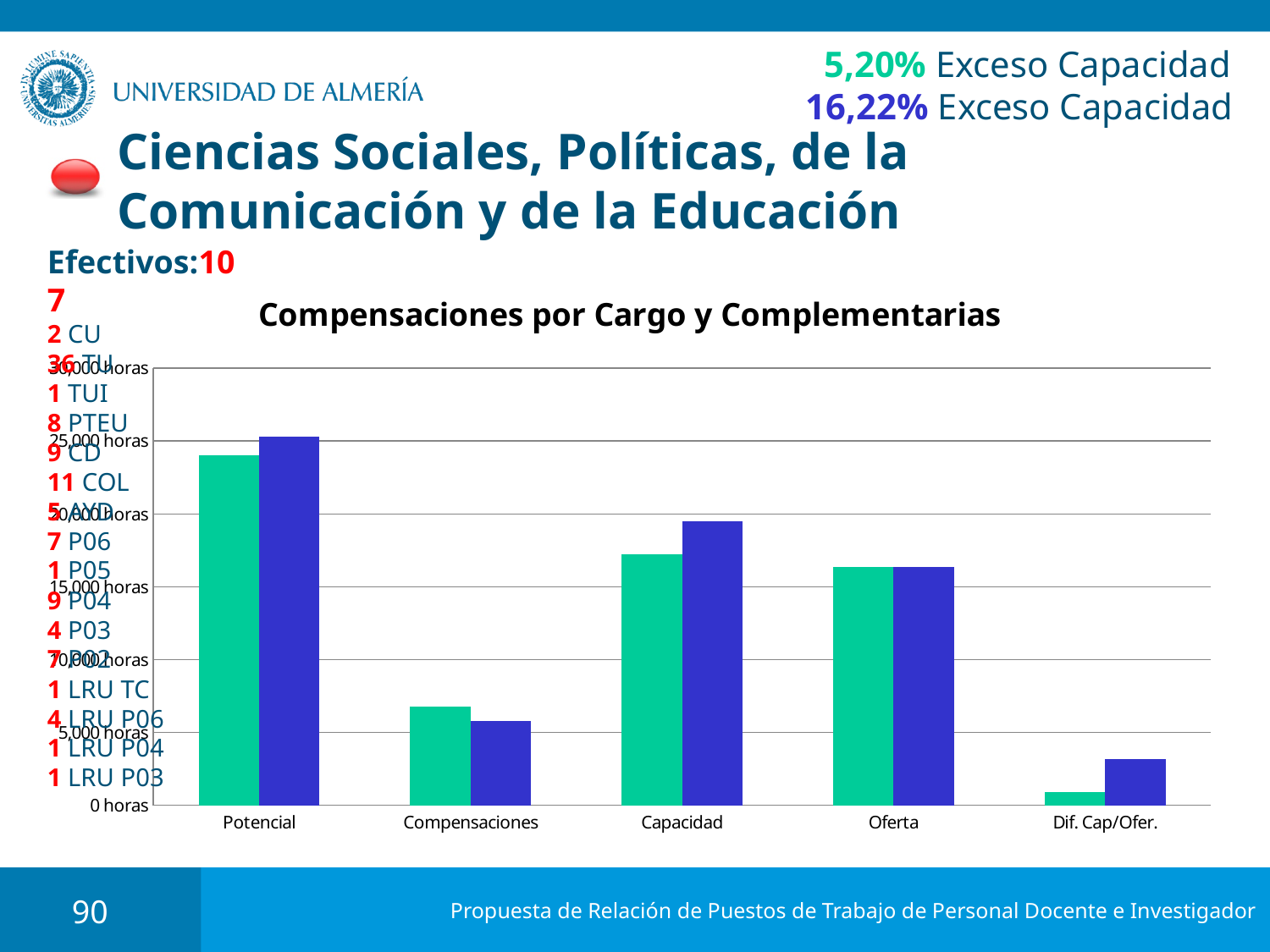
How many categories are shown on the x axis of the chart? 5 Which is larger, the green bar for Capacidad or the green bar for Oferta? Capacidad What is the highest tick label on the y axis of the chart? 30,000 horas For Dif. Cap/Ofer., which bar is taller, the green one or the blue one? the blue one Which category has the shortest bars in the chart? Dif. Cap/Ofer. Is the green bar for Capacidad greater or less than 15,000 horas? greater Is the blue bar for Compensaciones greater or less than 10,000 horas? less Which category has the tallest bars in the chart? Potencial Is the green bar for Potencial greater or less than 20,000 horas? greater What kind of chart is shown under the title 'Compensaciones por Cargo y Complementarias'? bar chart What is the title of the chart? Compensaciones por Cargo y Complementarias